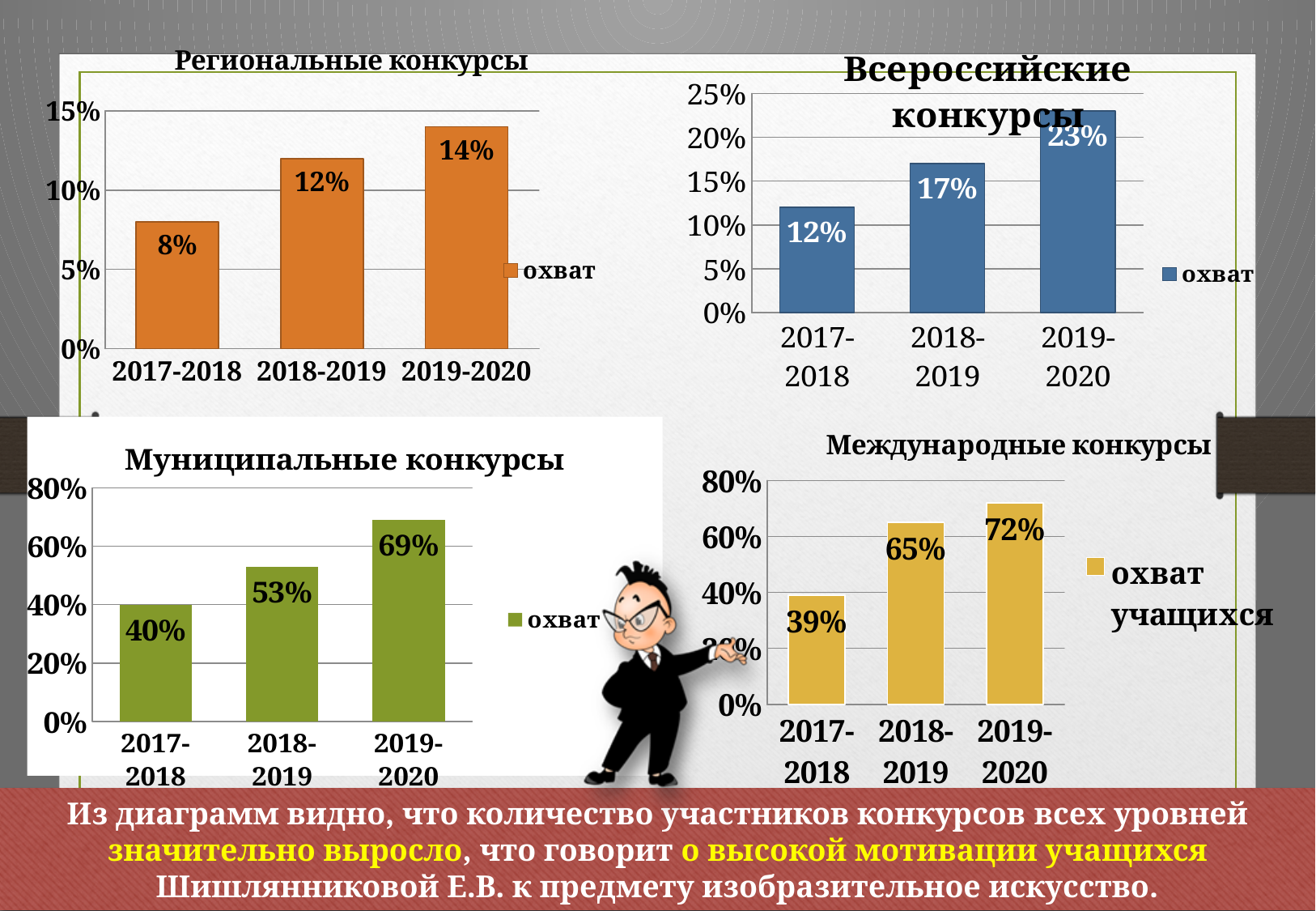
How many periods are shown on the x axis of the "Муниципальные конкурсы" chart? 3 In the "Региональные конкурсы" chart, do the values rise or fall from 2017-2018 to 2019-2020? rise In the "Международные конкурсы" chart, what is the value for 2017-2018? 39% In the "Всероссийские конкурсы" chart, what is the value for 2019-2020? 23% In the "Региональные конкурсы" chart, what is the difference between the values for 2019-2020 and 2017-2018? 6% In the "Муниципальные конкурсы" chart, which period has the highest value? 2019-2020 In the "Региональные конкурсы" chart, what is the value for 2017-2018? 8% In the "Международные конкурсы" chart, what is the difference between the values for 2018-2019 and 2017-2018? 26% In the "Муниципальные конкурсы" chart, what is the value for 2018-2019? 53% In the "Всероссийские конкурсы" chart, which is larger: the value for 2018-2019 or the value for 2017-2018? 2018-2019 What kind of chart is the "Международные конкурсы" chart? bar chart In the "Всероссийские конкурсы" chart, which period has the lowest value? 2017-2018